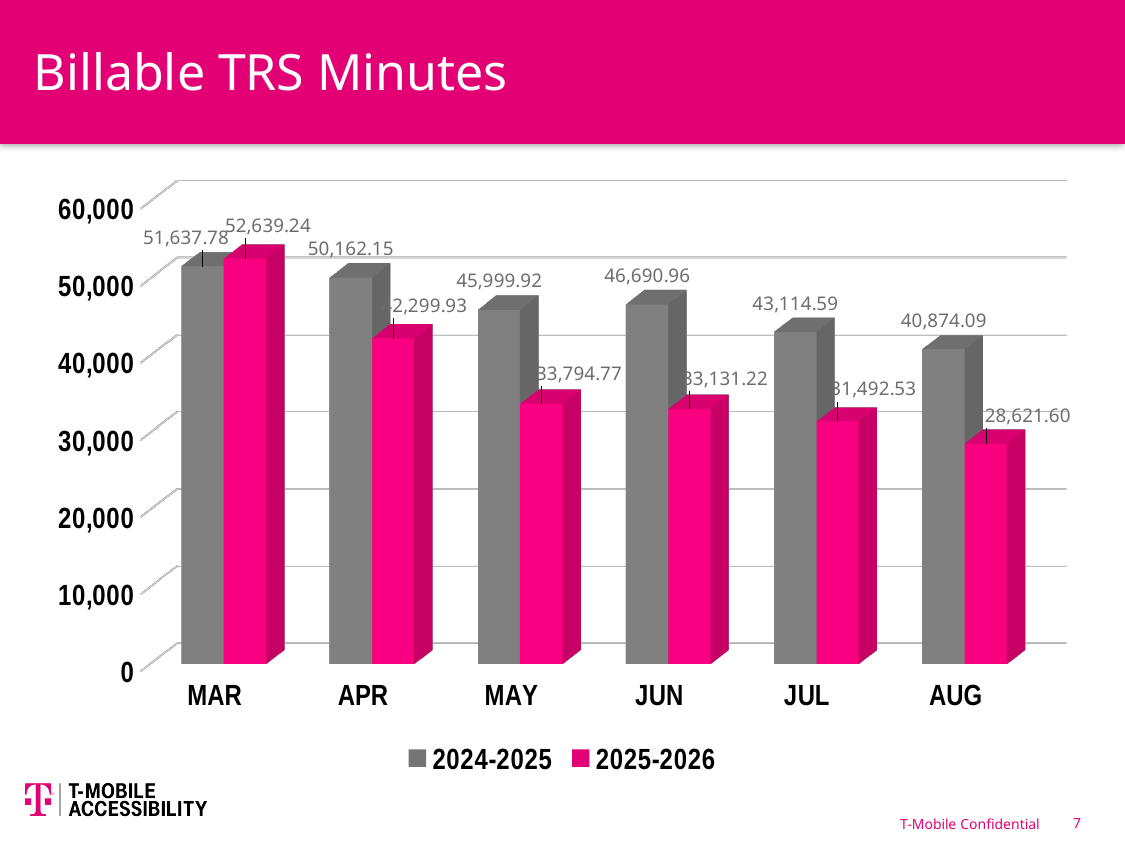
What is the value for 2025-2026 in AUG? 28,621.60 What is the difference between the 2024-2025 and 2025-2026 values in JUN? 13,559.74 How many series does the legend list? 2 What is the difference between the 2025-2026 and 2024-2025 values in MAR? 1,001.46 What kind of chart is shown on the slide? Bar chart How many months are shown on the x axis? 6 Is the value for 2025-2026 in JUL greater or less than 40,000? less Which is larger in APR, the 2024-2025 value or the 2025-2026 value? 2024-2025 What is the value for 2024-2025 in MAY? 45,999.92 Which month has the highest value for the 2025-2026 series? MAR What is the value for 2024-2025 in JUL? 43,114.59 Which month has the lowest value for the 2024-2025 series? AUG